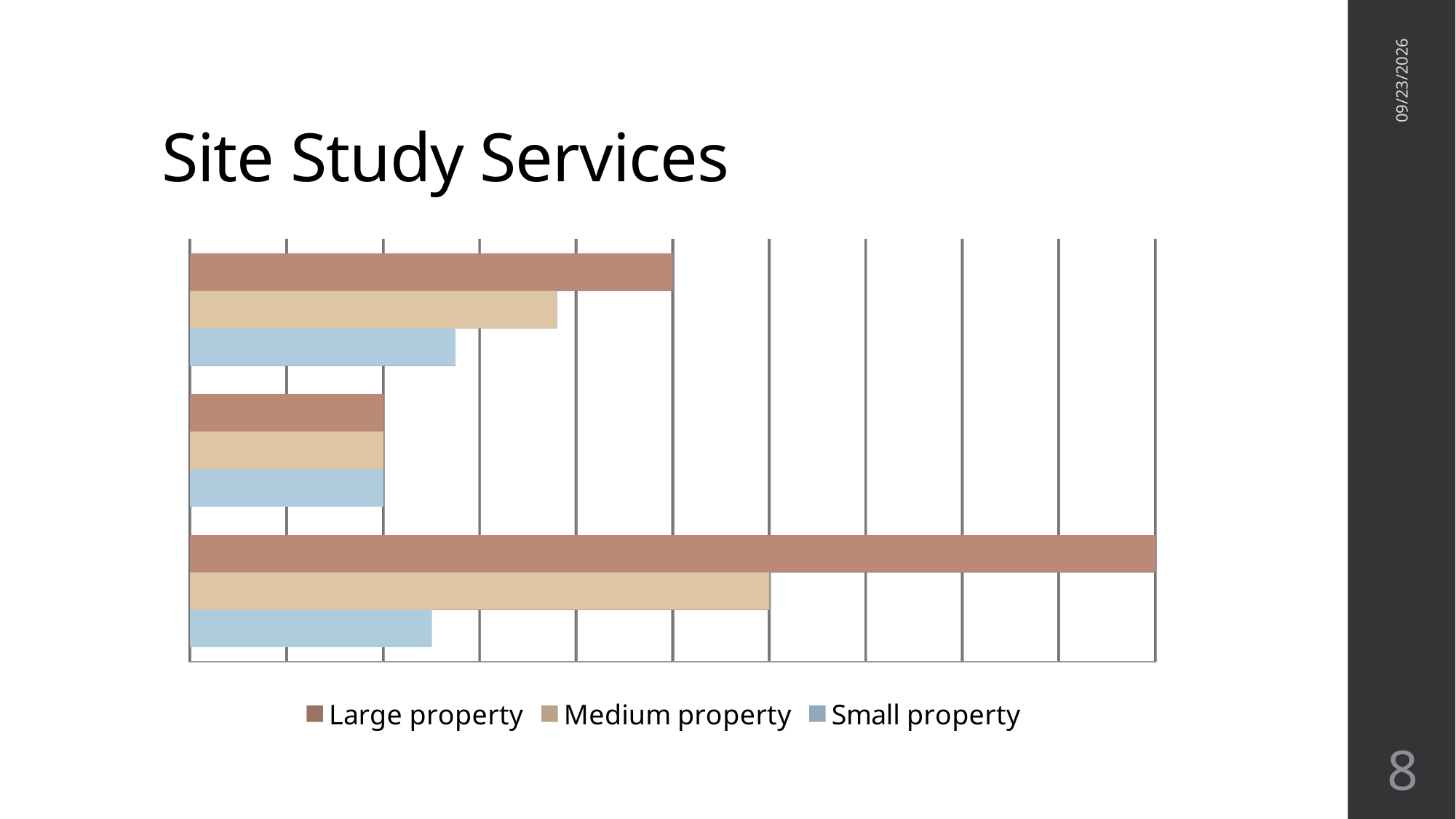
Which series has the longest bar in the whole chart? Large property In the top group of bars, which series has the shortest bar? Small property How many groups of bars are plotted in the chart? 3 What kind of chart is shown on the slide? bar chart In the bottom group of bars, which series has the shortest bar? Small property What are the series names listed in the legend? Large property, Medium property, Small property How many series does the legend list? 3 In the top group of bars, is the Large property bar longer or shorter than the Small property bar? longer What is the title of the slide containing the chart? Site Study Services